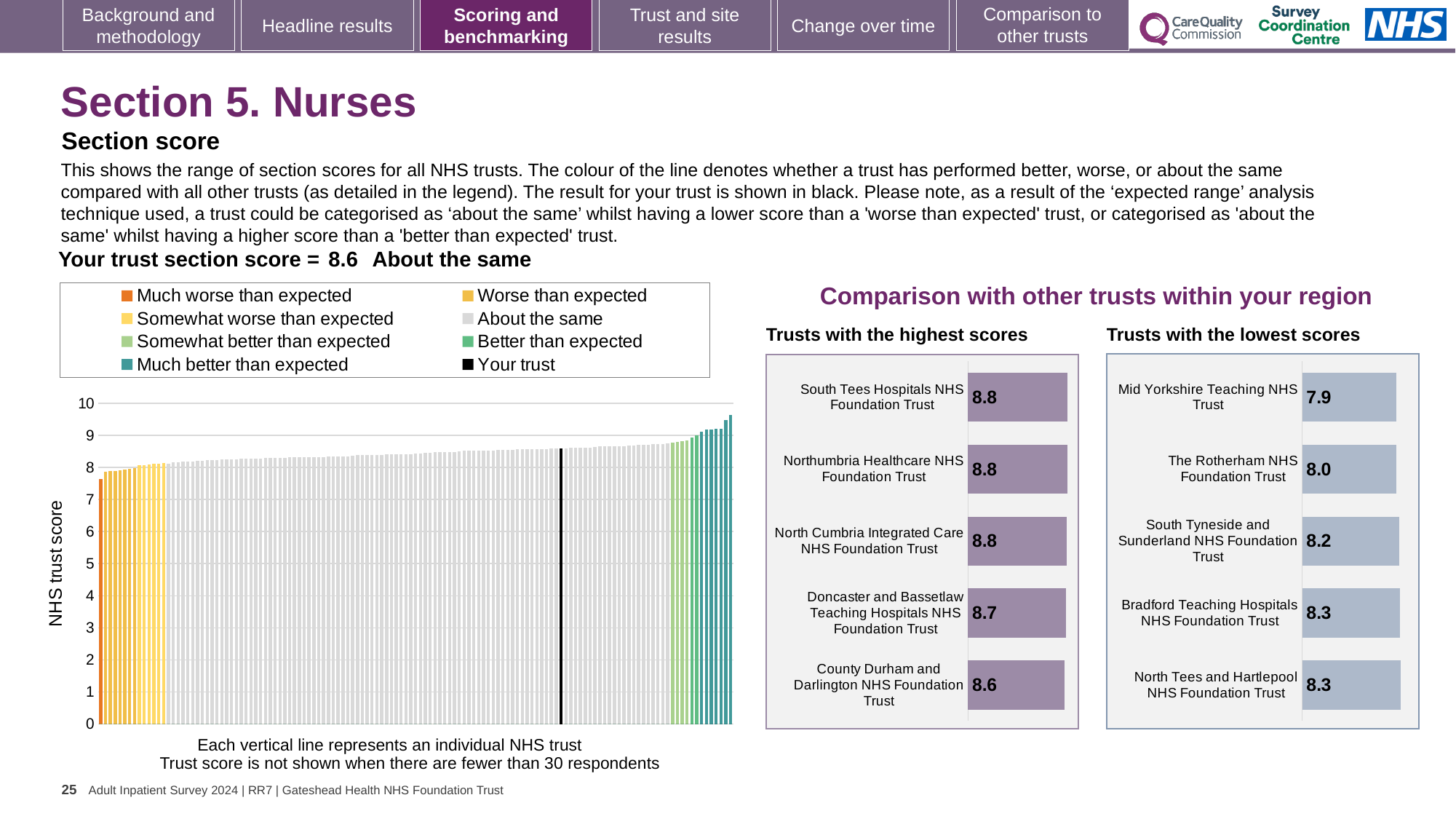
In the 'Trusts with the highest scores' chart, what is the score for Doncaster and Bassetlaw Teaching Hospitals NHS Foundation Trust? 8.7 How many entries does the legend of the chart on the left list? 8 In the 'Trusts with the highest scores' chart, what is the difference between the scores of South Tees Hospitals NHS Foundation Trust and County Durham and Darlington NHS Foundation Trust? 0.2 In the 'Trusts with the lowest scores' chart, what is the difference between the scores of Bradford Teaching Hospitals NHS Foundation Trust and Mid Yorkshire Teaching NHS Trust? 0.4 In the 'Trusts with the lowest scores' chart, which has the higher score: The Rotherham NHS Foundation Trust or South Tyneside and Sunderland NHS Foundation Trust? South Tyneside and Sunderland NHS Foundation Trust In the 'Trusts with the highest scores' chart, what is the score for County Durham and Darlington NHS Foundation Trust? 8.6 What kind of chart is the 'Trusts with the lowest scores' chart? Bar chart In the 'Trusts with the lowest scores' chart, which trust has the lowest score? Mid Yorkshire Teaching NHS Trust What is the y-axis label of the chart on the left? NHS trust score How many trusts are listed in the 'Trusts with the highest scores' chart? 5 In the chart on the left showing all NHS trusts, is the value for the black 'Your trust' bar greater or less than 8? greater In the 'Trusts with the lowest scores' chart, what is the score for The Rotherham NHS Foundation Trust? 8.0